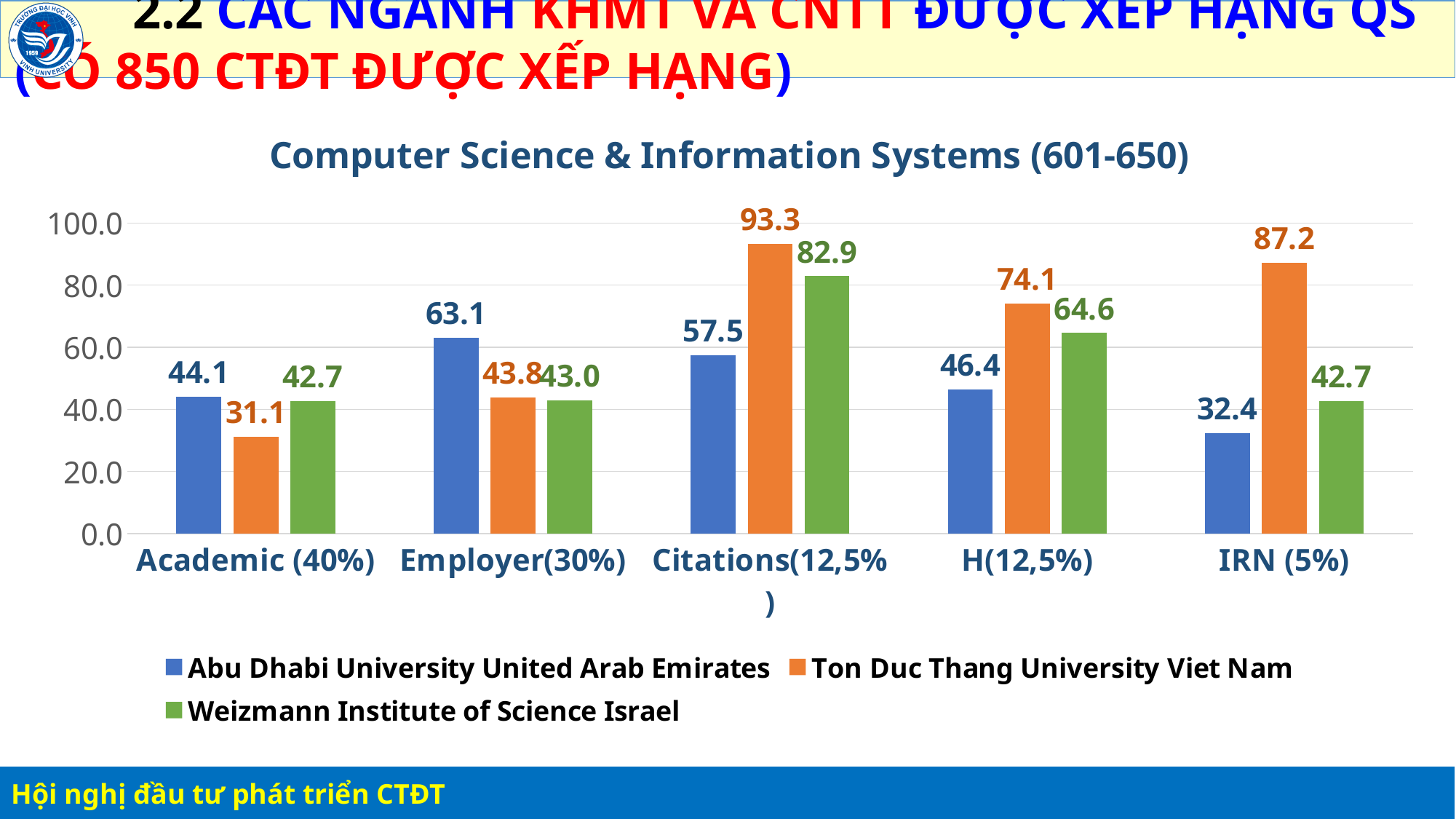
How many categories are shown on the x axis? 5 What kind of chart is shown on the slide? Bar chart What is the difference between Ton Duc Thang University Viet Nam and Abu Dhabi University United Arab Emirates in the IRN (5%) category? 54.8 What is the value for Ton Duc Thang University Viet Nam in the Citations(12,5%) category? 93.3 In which category does Ton Duc Thang University Viet Nam have its highest value? Citations(12,5%) What is the title of the chart? Computer Science & Information Systems (601-650) Which is larger in the Academic (40%) category: Abu Dhabi University United Arab Emirates or Ton Duc Thang University Viet Nam? Abu Dhabi University United Arab Emirates In which category does Abu Dhabi University United Arab Emirates have its lowest value? IRN (5%) Is the value for Weizmann Institute of Science Israel in the Citations(12,5%) category greater or less than 80.0? greater How many series does the legend list? 3 What is the value for Abu Dhabi University United Arab Emirates in the Employer(30%) category? 63.1 What is the value for Weizmann Institute of Science Israel in the H(12,5%) category? 64.6